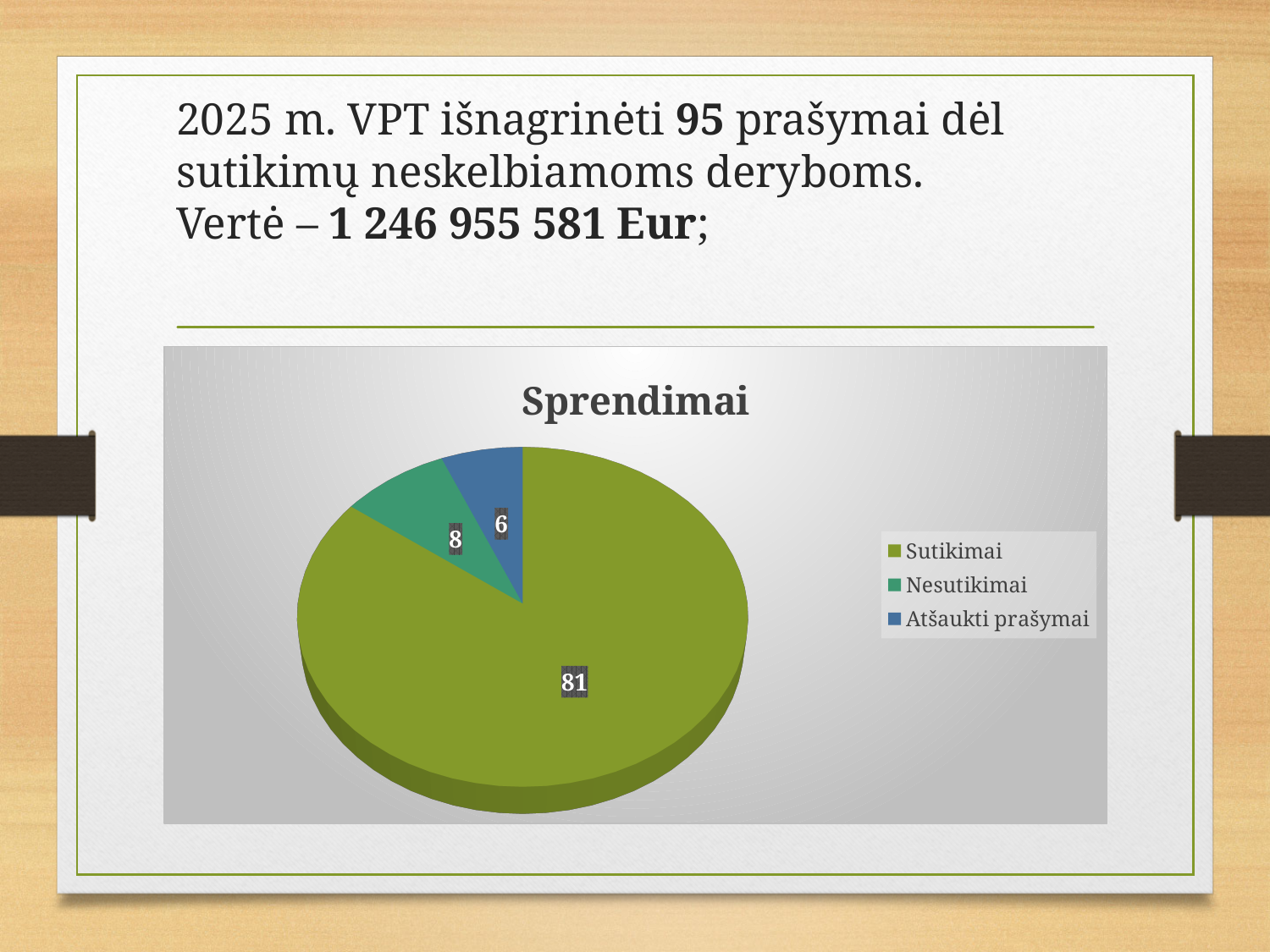
What is the title of the chart? Sprendimai Which is larger, the value for Nesutikimai or the value for Atšaukti prašymai? Nesutikimai What is the value for Nesutikimai? 8 What is the difference between the values for Sutikimai and Nesutikimai? 73 What is the value for Atšaukti prašymai? 6 Which category has the largest slice of the pie? Sutikimai What is the value for Sutikimai? 81 How many categories does the pie chart have? 3 Which category has the smallest slice of the pie? Atšaukti prašymai What is the total of all slices in the pie chart? 95 What is the difference between the values for Nesutikimai and Atšaukti prašymai? 2 What type of chart is shown on the slide? pie chart